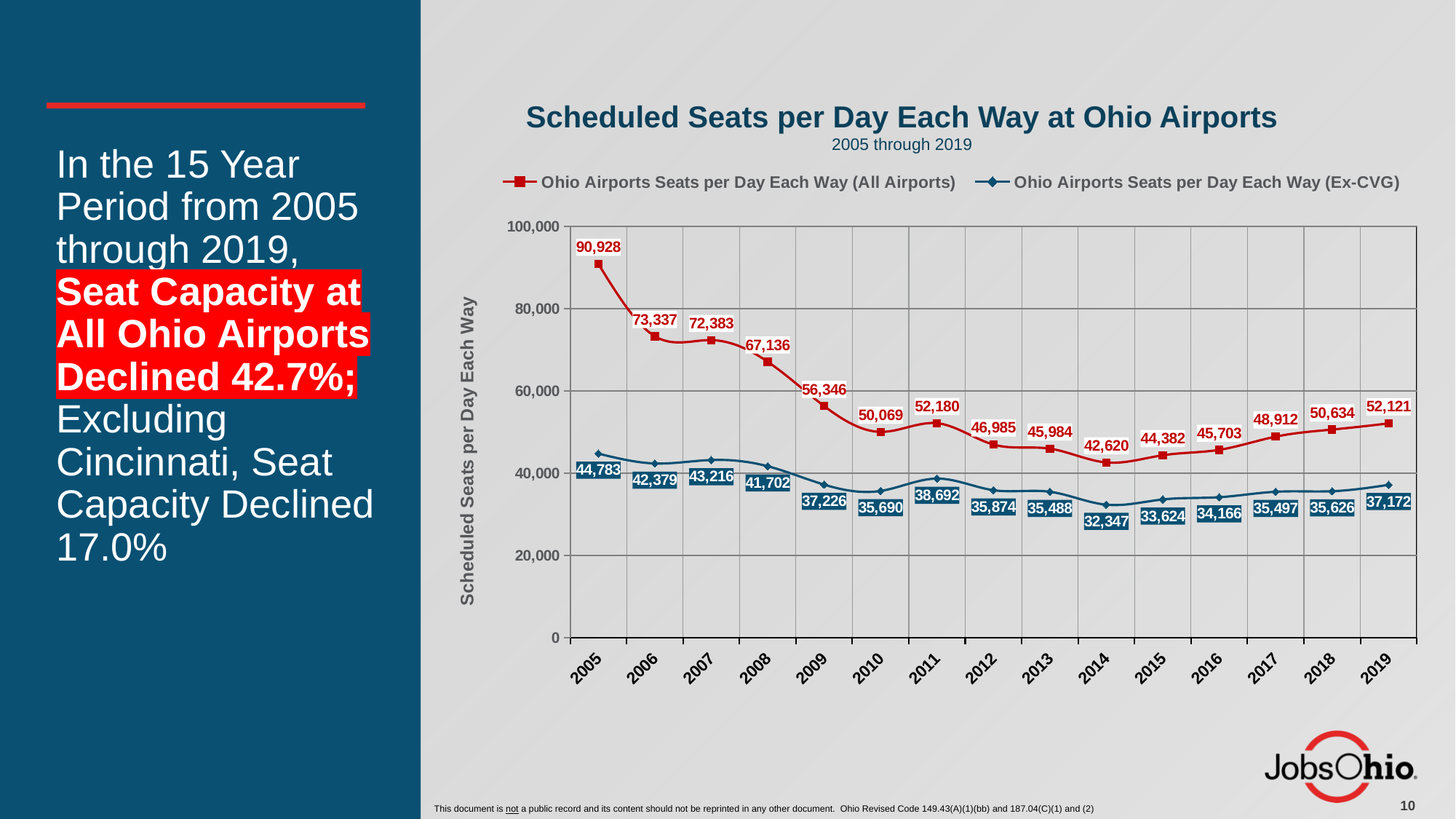
What was the value for Ohio Airports Seats per Day Each Way (All Airports) in 2011? 52,180 What is the difference between the All Airports value and the Ex-CVG value in 2005? 46,145 What was the value for Ohio Airports Seats per Day Each Way (All Airports) in 2005? 90,928 How many years are plotted on the x axis? 15 In which year was Ohio Airports Seats per Day Each Way (Ex-CVG) highest? 2005 How many series does the legend list? 2 In which year was Ohio Airports Seats per Day Each Way (All Airports) lowest? 2014 Which is larger: the Ex-CVG value in 2011 or the Ex-CVG value in 2012? 2011 By how much did Ohio Airports Seats per Day Each Way (All Airports) fall from 2005 to 2019? 38,807 What is the title of the chart? Scheduled Seats per Day Each Way at Ohio Airports What was the value for Ohio Airports Seats per Day Each Way (Ex-CVG) in 2019? 37,172 What kind of chart is shown on the slide? Line chart